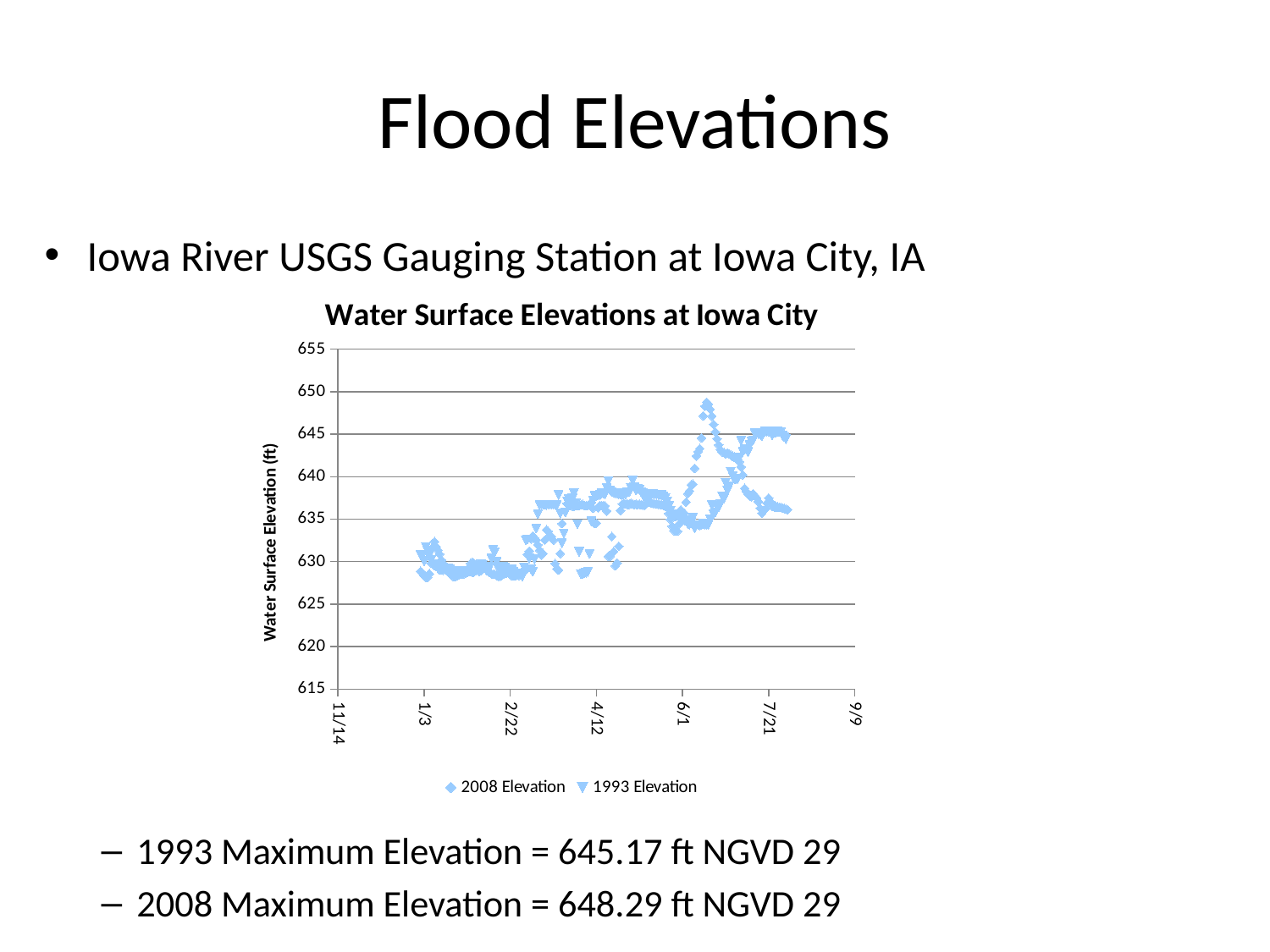
Do the water surface elevations generally rise or fall from January to July on the chart? rise What is the 1993 maximum elevation stated on the slide? 645.17 ft NGVD 29 How many series does the chart legend list? 2 What is the 2008 maximum elevation stated on the slide? 648.29 ft NGVD 29 Around 7/21, which series shows the higher water surface elevation, 2008 Elevation or 1993 Elevation? 1993 Elevation What is the title of the chart? Water Surface Elevations at Iowa City Which series reaches the highest water surface elevation on the chart? 2008 Elevation By how many feet does the 2008 maximum elevation exceed the 1993 maximum elevation? 3.12 ft Is the peak value of the 1993 Elevation series greater or less than 650? less What is the label on the vertical axis of the chart? Water Surface Elevation (ft) What kind of chart is shown on the slide? scatter chart Is the peak value of the 2008 Elevation series greater or less than 645? greater